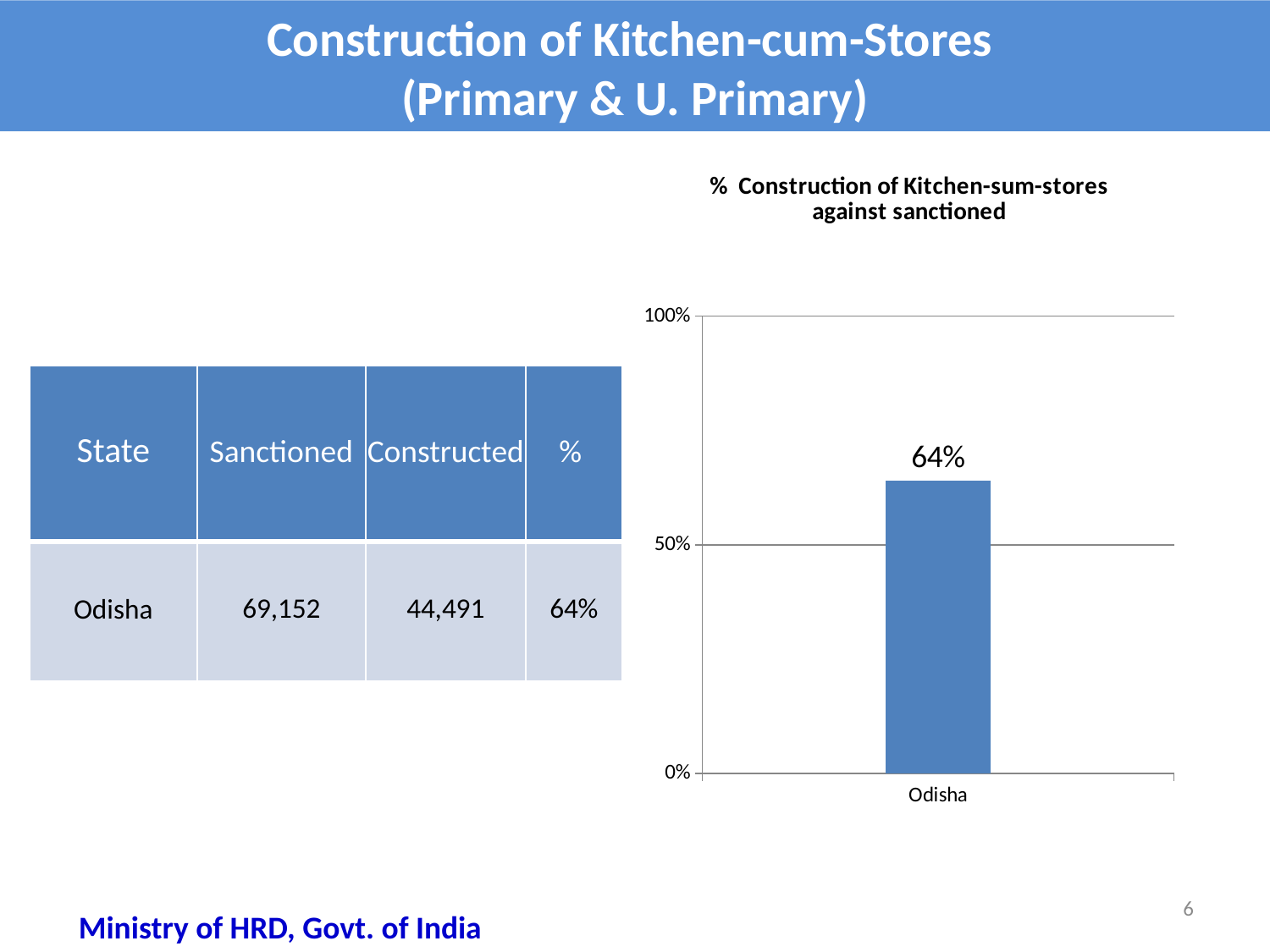
Is the value for Odisha greater or less than 50%? greater How many categories are plotted in the chart? 1 What is the highest value shown on the chart's vertical axis? 100% What is the value for Odisha in the chart? 64% Which category is shown on the x axis of the chart? Odisha Is the value for Odisha greater or less than 100%? less What is the title of the chart? % Construction of Kitchen-sum-stores against sanctioned What kind of chart is shown on the slide? bar chart